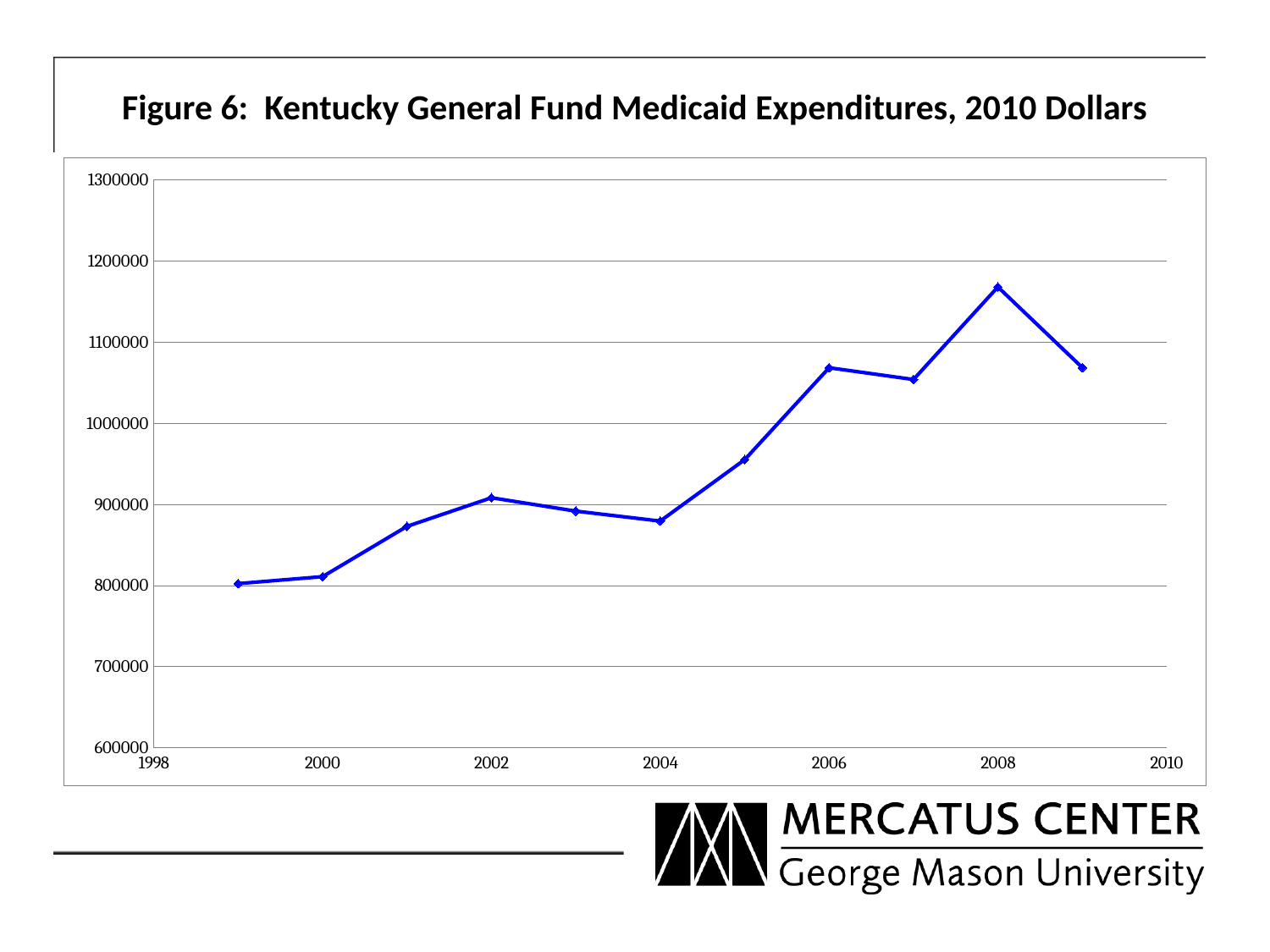
What is the title of the chart? Figure 6: Kentucky General Fund Medicaid Expenditures, 2010 Dollars Is the value for 2006 greater or less than 1000000? greater What kind of chart is shown on the slide? line chart Is the value for 2001 greater or less than 900000? less Is the value for 2008 greater or less than 1100000? greater Which year has the larger value, 2004 or 2005? 2005 Do the values generally rise or fall from 1999 to 2008? rise In which year is the expenditure highest? 2008 Which year has the larger value, 2008 or 2009? 2008 How many data points are plotted on the line? 11